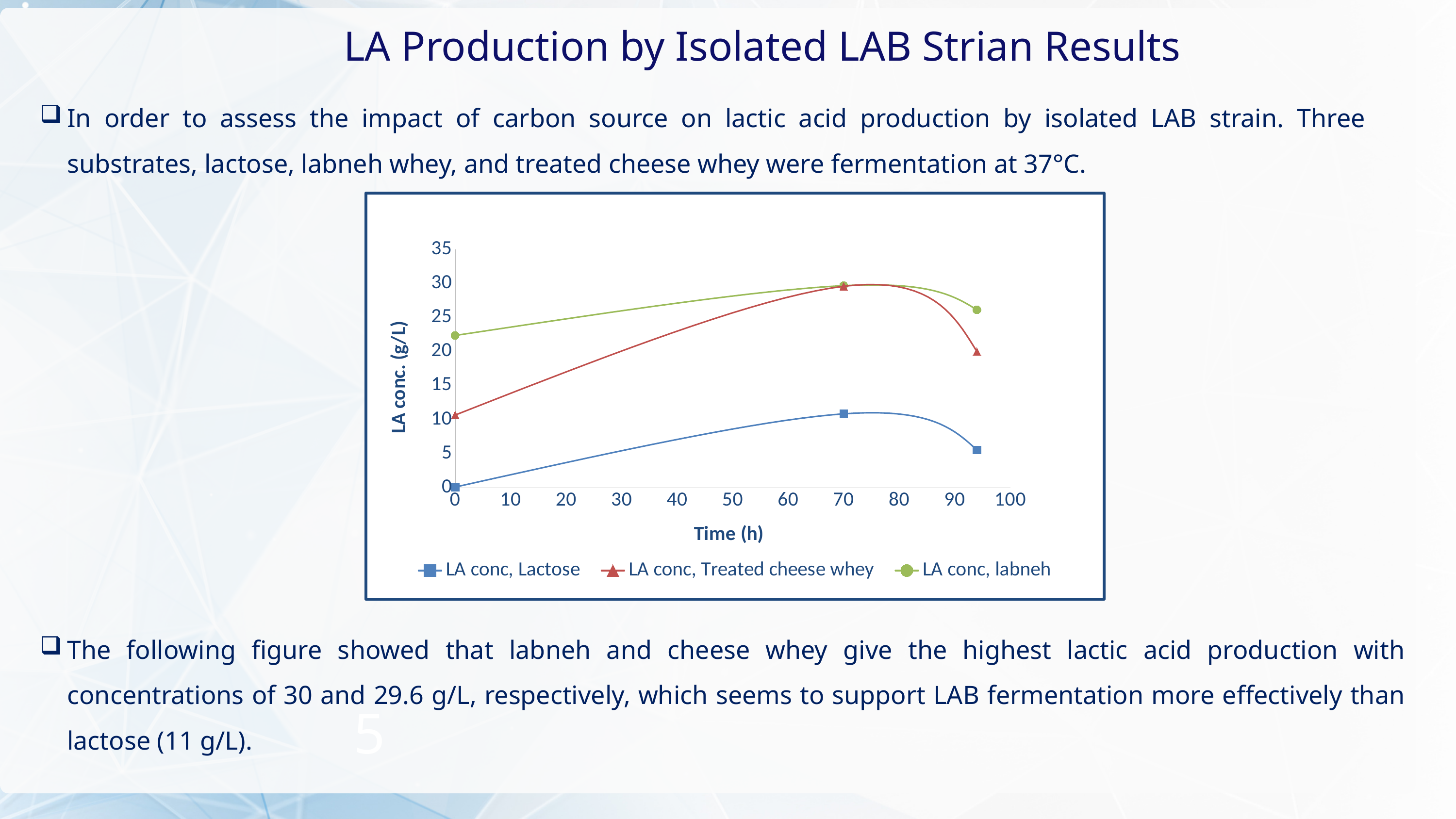
Does the LA conc, Lactose series rise or fall between 0 h and 70 h? rise At the last time point, which is larger: LA conc, Treated cheese whey or LA conc, Lactose? LA conc, Treated cheese whey What is the label of the x axis? Time (h) Is the value for LA conc, labneh at 0 h greater or less than 20? greater What kind of chart is shown on the slide? line chart What is the label of the y axis? LA conc. (g/L) How many series does the chart legend list? 3 How many data points are plotted for the LA conc, Lactose series? 3 Which series has the lowest LA concentration at time 0 h? LA conc, Lactose Which series has the highest LA concentration at time 0 h? LA conc, labneh Is the value for LA conc, Lactose at 70 h greater or less than 15? less Is the final value for LA conc, Treated cheese whey (at about 94 h) greater or less than 25? less